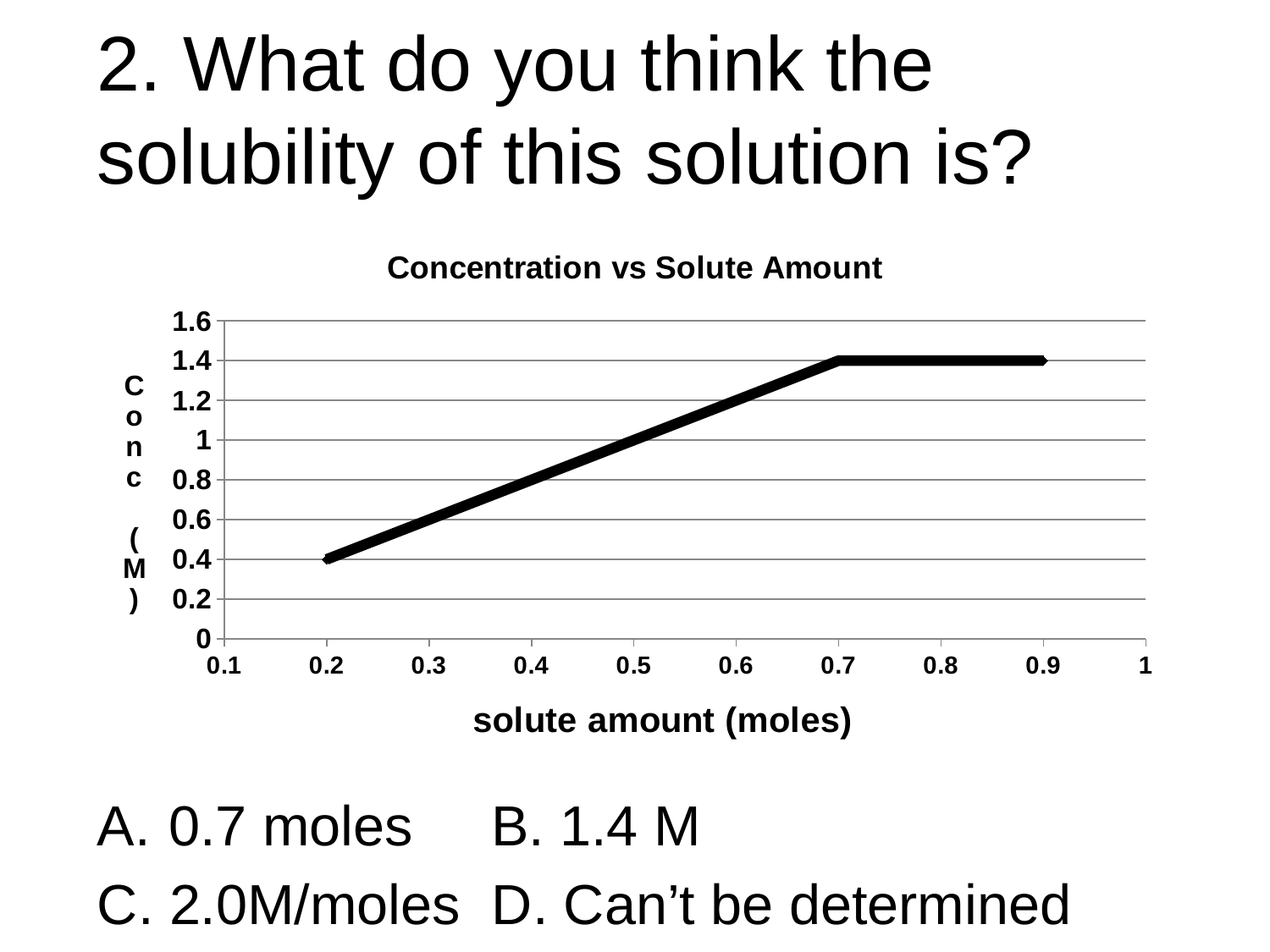
What is the label of the x axis of the chart? solute amount (moles) What is the concentration (M) at a solute amount of 0.9 moles? 1.4 What is the highest concentration value reached by the line? 1.4 What is the difference in concentration between a solute amount of 0.7 moles and 0.2 moles? 1 What is the concentration (M) at a solute amount of 0.2 moles? 0.4 What is the title of the chart? Concentration vs Solute Amount What is the concentration (M) at a solute amount of 0.7 moles? 1.4 Does the concentration rise, fall or stay flat as solute amount increases from 0.7 to 0.9 moles? stay flat Is the concentration at a solute amount of 0.5 moles greater or less than 0.8? greater Does the concentration rise, fall or stay flat as solute amount increases from 0.2 to 0.7 moles? rise Is the concentration at a solute amount of 0.3 moles greater or less than 0.8? less What kind of chart is shown on the slide? line chart